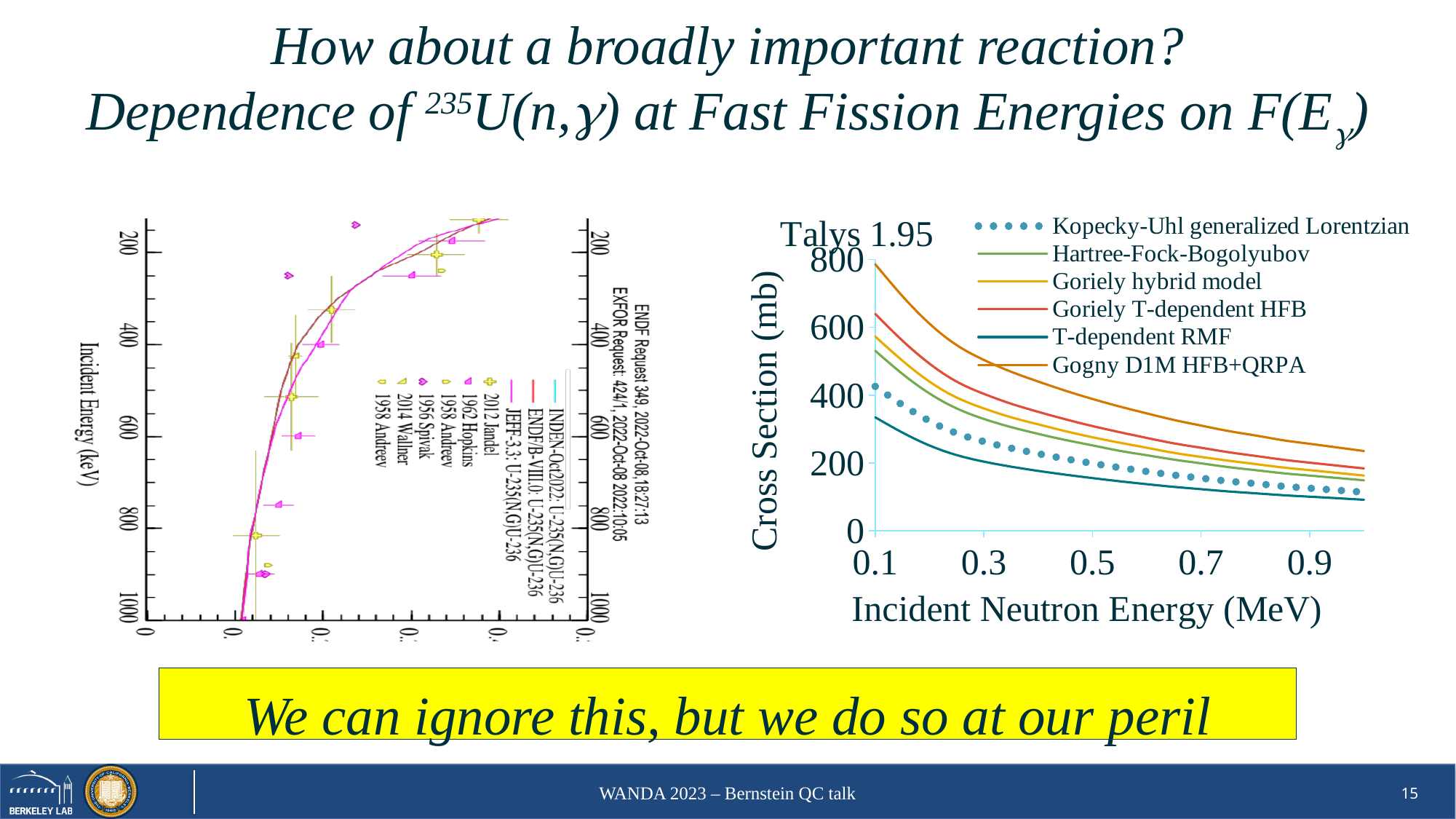
What is the x-axis label of the Talys 1.95 chart? Incident Neutron Energy (MeV) In the Talys 1.95 chart, which series has the larger cross section at 0.5 MeV: Goriely T-dependent HFB or Kopecky-Uhl generalized Lorentzian? Goriely T-dependent HFB In the Talys 1.95 chart, is the cross section for Gogny D1M HFB+QRPA at 0.1 MeV greater or less than 600 mb? greater In the Talys 1.95 chart, is the cross section for Hartree-Fock-Bogolyubov at 0.1 MeV greater or less than 600 mb? less In the Talys 1.95 chart, which series is drawn as a dotted line? Kopecky-Uhl generalized Lorentzian In the Talys 1.95 chart, is the cross section for T-dependent RMF at 0.1 MeV greater or less than 400 mb? less In the Talys 1.95 chart, which series has the highest cross section across the plotted energy range? Gogny D1M HFB+QRPA In the Talys 1.95 chart, which series has the lowest cross section across the plotted energy range? T-dependent RMF How many series does the legend of the Talys 1.95 chart list? 6 What kind of chart is the Talys 1.95 chart on the right of the slide? line chart In the Talys 1.95 chart, do the cross sections rise or fall as incident neutron energy increases? fall